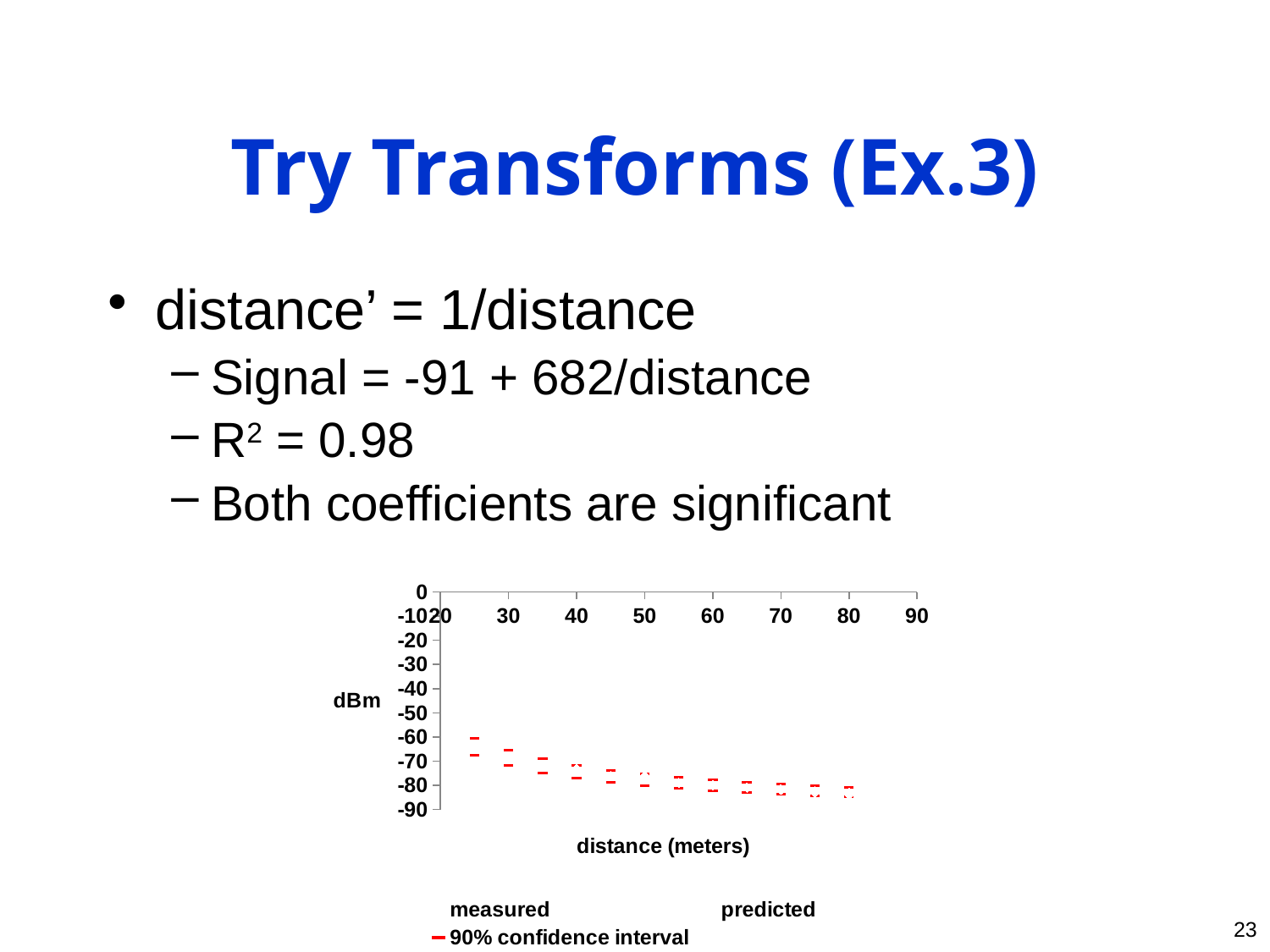
Is the plotted dBm value at a distance of about 80 meters greater or less than -70? less What is the label on the chart's y axis? dBm Which has the higher plotted dBm value: the point near 25 meters or the point near 80 meters? the point near 25 meters Do the plotted dBm values rise or fall as distance increases along the x axis? fall What is the highest value shown on the chart's x axis? 90 What is the label on the chart's x axis? distance (meters) Is the plotted dBm value at a distance of about 25 meters greater or less than -50? less Is the plotted dBm value at a distance of about 25 meters greater or less than -80? greater How many series does the chart's legend list? 3 What kind of chart is shown on the slide? scatter chart